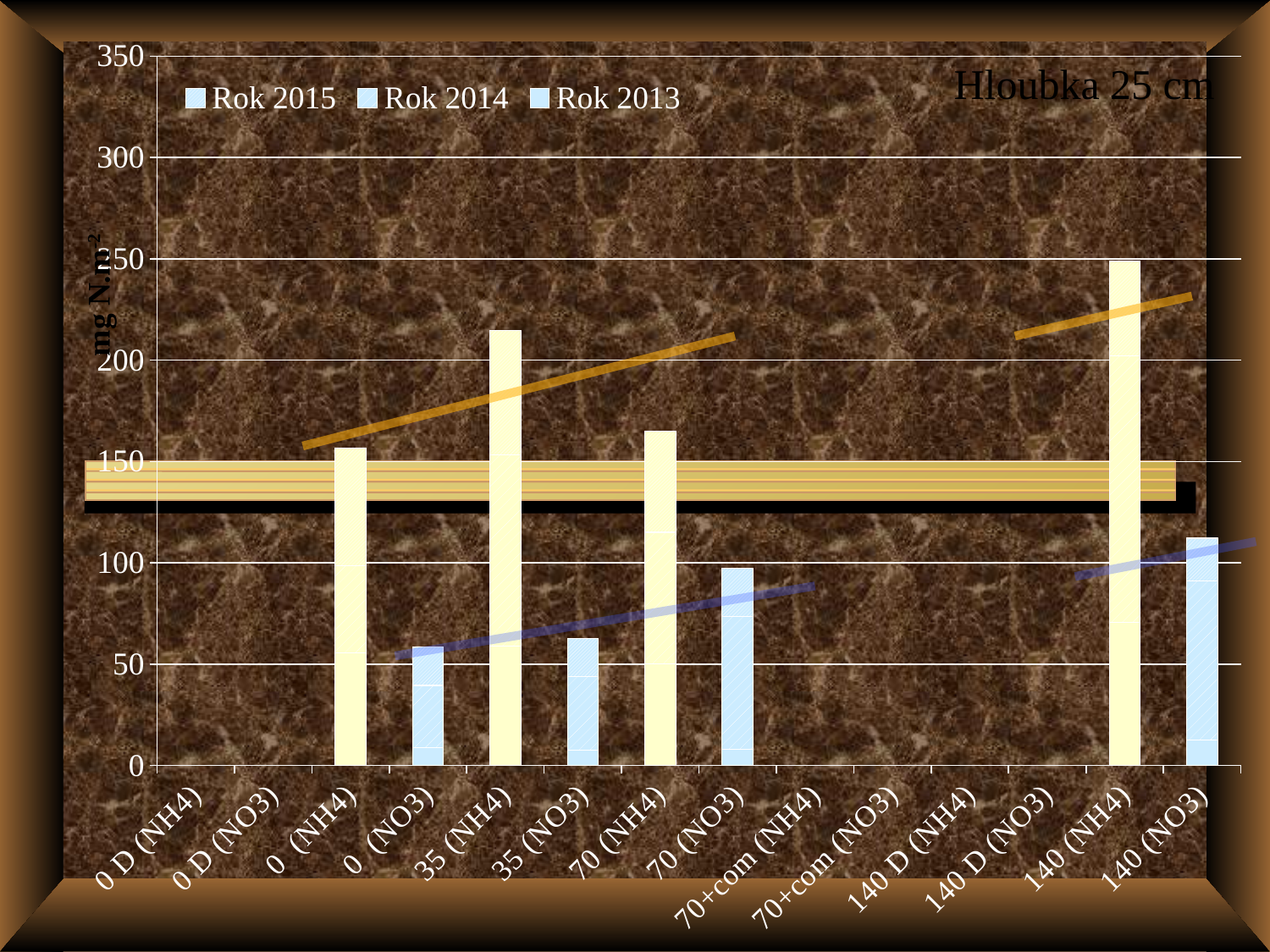
How many categories are shown on the x axis? 14 Which is larger, the bar for 70 (NO3) or the bar for 0 (NO3)? 70 (NO3) How many series does the legend list? 3 What kind of chart is shown on the slide? bar chart Is the value for 70 (NH4) greater or less than 150? greater Which category has the highest bar? 140 (NH4) Which is larger, the bar for 35 (NH4) or the bar for 70 (NH4)? 35 (NH4) Is the value for 140 (NH4) greater or less than 200? greater What is the title of the chart? Hloubka 25 cm Is the value for 140 (NO3) greater or less than 100? greater